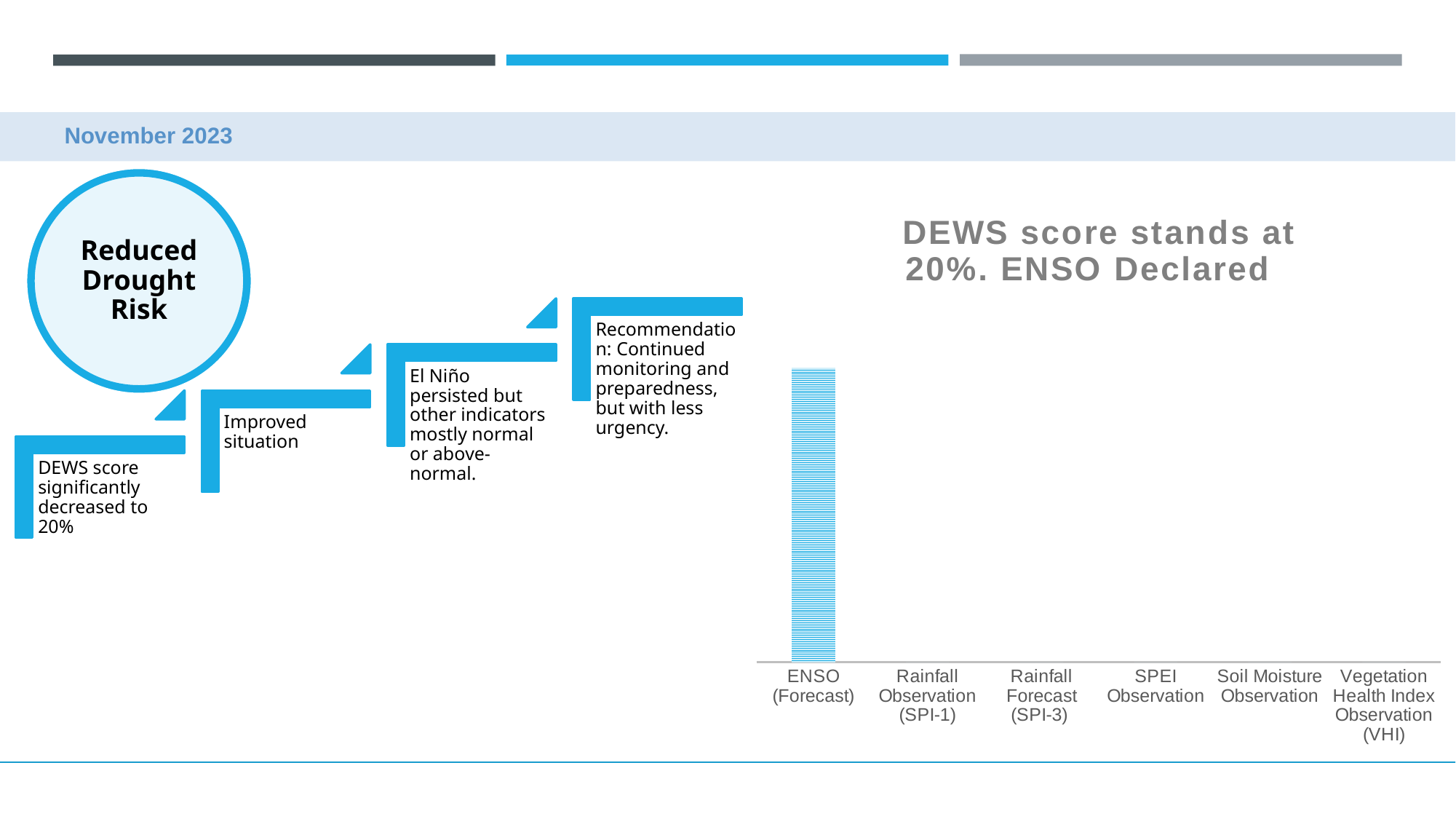
How many categories in the bar chart show no visible bar? 5 Which category in the bar chart has the tallest bar? ENSO (Forecast) What is the label of the first category on the x axis of the bar chart? ENSO (Forecast) Which is larger in the bar chart, the bar for ENSO (Forecast) or the bar for SPEI Observation? ENSO (Forecast) Which is larger in the bar chart, the bar for Rainfall Observation (SPI-1) or the bar for ENSO (Forecast)? ENSO (Forecast) How many categories are listed along the x axis of the bar chart? 6 What kind of chart is shown on the right side of the slide? bar chart What is the label of the last category on the x axis of the bar chart? Vegetation Health Index Observation (VHI) Does the bar chart show a visible bar for Soil Moisture Observation? No How many categories in the bar chart show a visible bar? 1